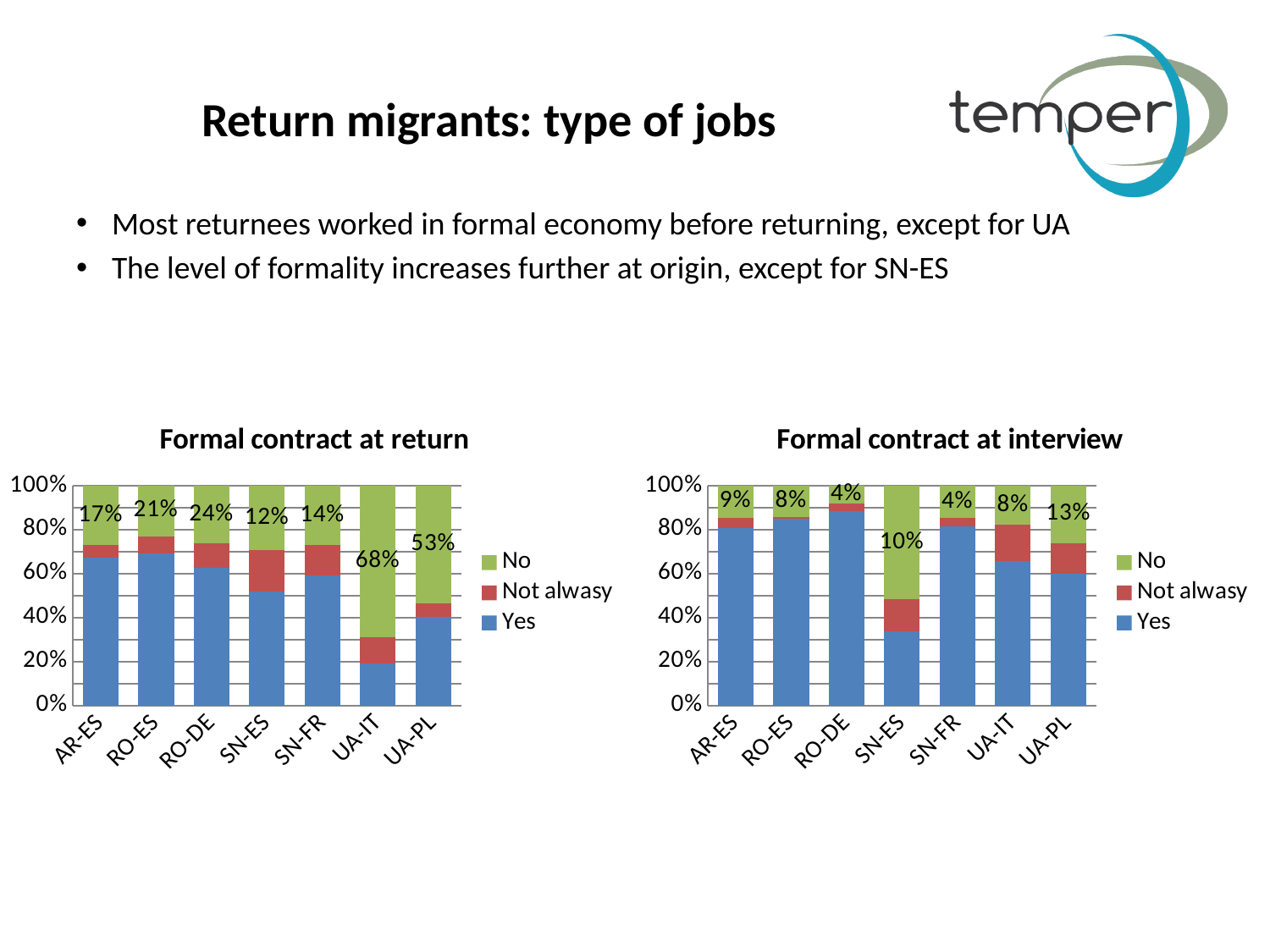
In the 'Formal contract at interview' chart, what data label is printed on the UA-PL bar? 13% What are the three legend entries of the 'Formal contract at interview' chart? No, Not alwasy, Yes In the 'Formal contract at return' chart, what data label is printed on the RO-DE bar? 24% How many categories are shown on the x axis of the 'Formal contract at interview' chart? 7 How many series does the legend of the 'Formal contract at return' chart list? 3 In the 'Formal contract at return' chart, what is the difference between the data labels printed on the UA-IT and UA-PL bars? 15% In the 'Formal contract at return' chart, what data label is printed on the UA-IT bar? 68% In the 'Formal contract at interview' chart, is the 'Yes' value for SN-ES greater or less than 40%? less In the 'Formal contract at interview' chart, what data label is printed on the AR-ES bar? 9% In the 'Formal contract at return' chart, which category has the lowest printed data label? SN-ES In the 'Formal contract at return' chart, which category has the highest printed data label? UA-IT What type of chart is the 'Formal contract at return' chart? bar chart